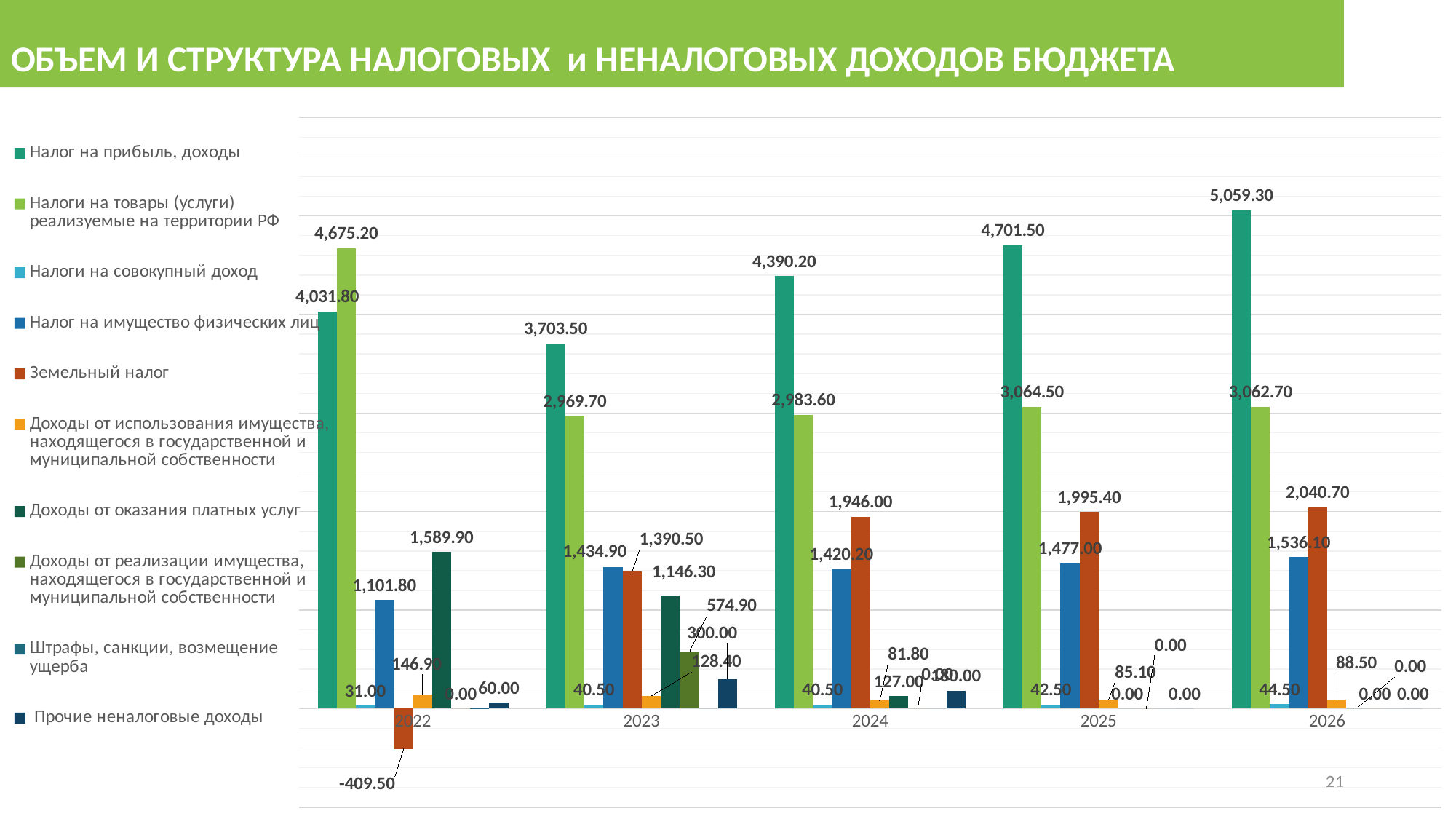
In which year is Налог на прибыль, доходы the highest? 2026 How many years are shown on the x axis? 5 What is the difference between Налог на прибыль, доходы in 2026 and in 2022? 1,027.50 What is the value of Налог на имущество физических лиц for 2025? 1,477.00 In 2022, which is larger: Налог на прибыль, доходы or Налоги на товары (услуги) реализуемые на территории РФ? Налоги на товары (услуги) реализуемые на территории РФ In which year is Налог на прибыль, доходы the lowest? 2023 What is the value of Налог на прибыль, доходы for 2026? 5,059.30 What kind of chart is shown on the slide? Bar chart What is the value of Земельный налог for 2022? -409.50 What is the difference between Земельный налог in 2026 and in 2025? 45.30 What is the value of Налоги на товары (услуги) реализуемые на территории РФ for 2022? 4,675.20 How many series does the legend list? 10